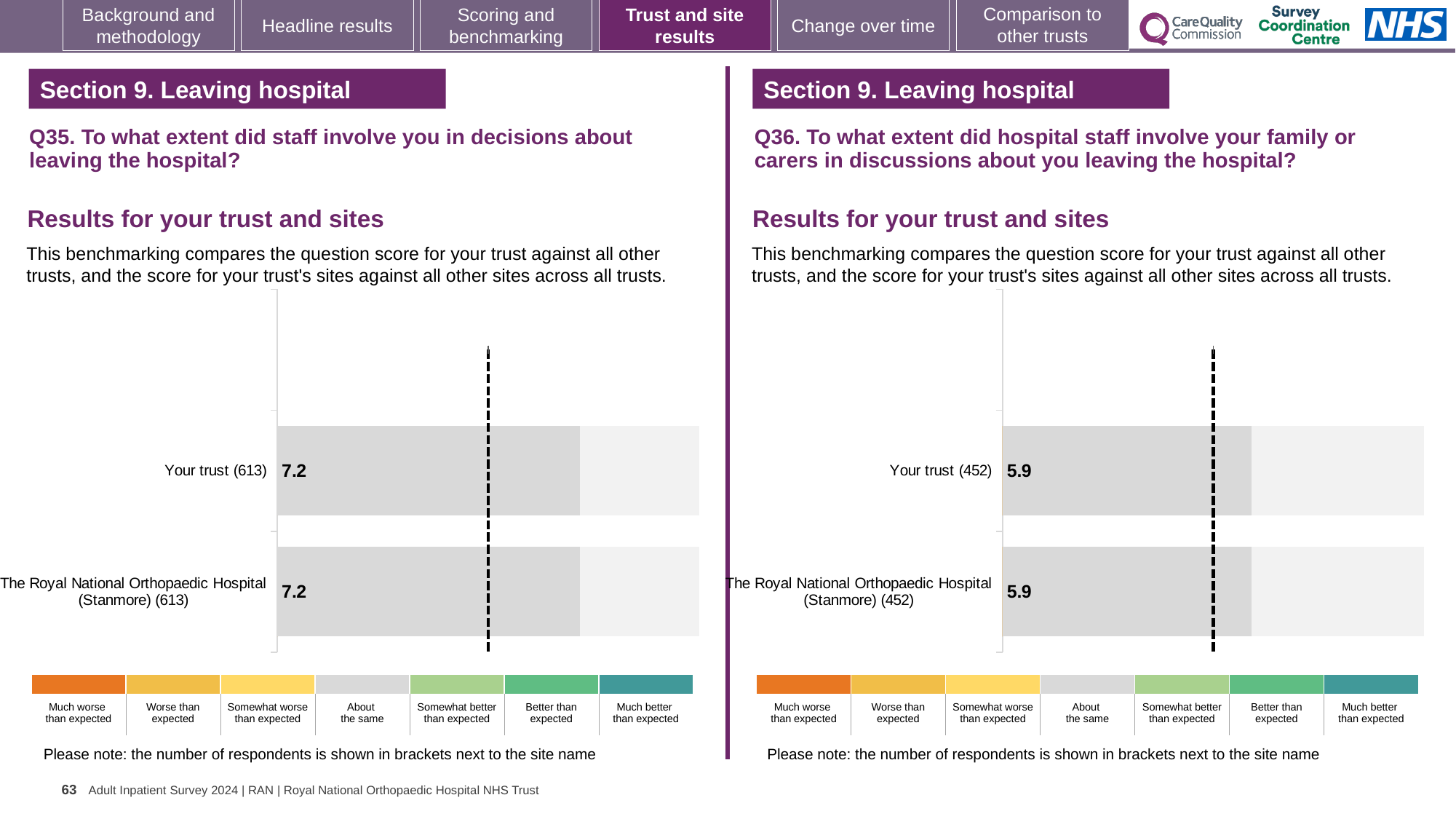
What is the difference between the Your trust score in the Q35 chart on the left and the Your trust score in the Q36 chart on the right? 1.3 In the Q35 chart on the left, how many respondents are shown in brackets for Your trust? 613 How many bars are plotted in the Q36 chart on the right? 2 In the Q35 chart on the left, what is the difference between the score for Your trust and the score for The Royal National Orthopaedic Hospital (Stanmore)? 0 In the Q35 chart on the left, what is the score for Your trust? 7.2 In the Q36 chart on the right, what is the score for Your trust? 5.9 In the Q35 chart on the left, what is the score for The Royal National Orthopaedic Hospital (Stanmore)? 7.2 In the Q36 chart on the right, how many respondents are shown in brackets for The Royal National Orthopaedic Hospital (Stanmore)? 452 What type of chart is used for the Q35 results on the left? Bar chart Is the score for Your trust in the Q36 chart on the right greater or less than the score for Your trust in the Q35 chart on the left? less In the Q36 chart on the right, what is the score for The Royal National Orthopaedic Hospital (Stanmore)? 5.9 How many bars are plotted in the Q35 chart on the left? 2